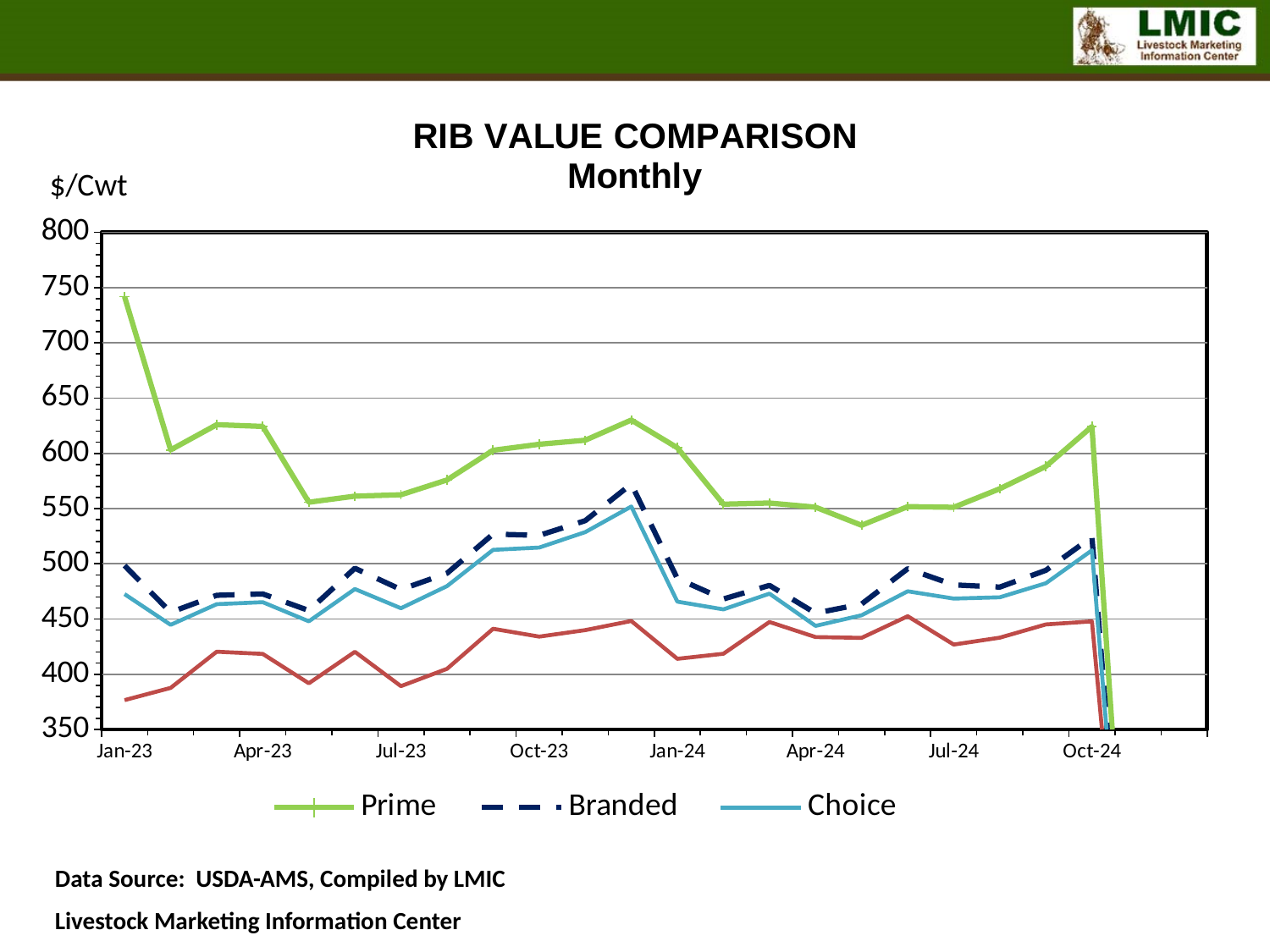
What unit is shown on the vertical axis of the chart? $/Cwt Is the value for Prime in Jan-23 greater or less than 700? greater In Jan-24, which is higher, Prime or Choice? Prime Is the value for Prime in Apr-23 greater or less than 600? greater Is the value for Choice in Jan-23 greater or less than 500? less Does the Branded line rise or fall from Jul-23 to Dec-23? rise How many series does the legend list? 3 Which series has the highest values across the whole period shown? Prime Does the Prime line rise or fall from Jan-23 to Feb-23? fall What kind of chart is shown on the slide? line chart What is the title of the chart? RIB VALUE COMPARISON Monthly